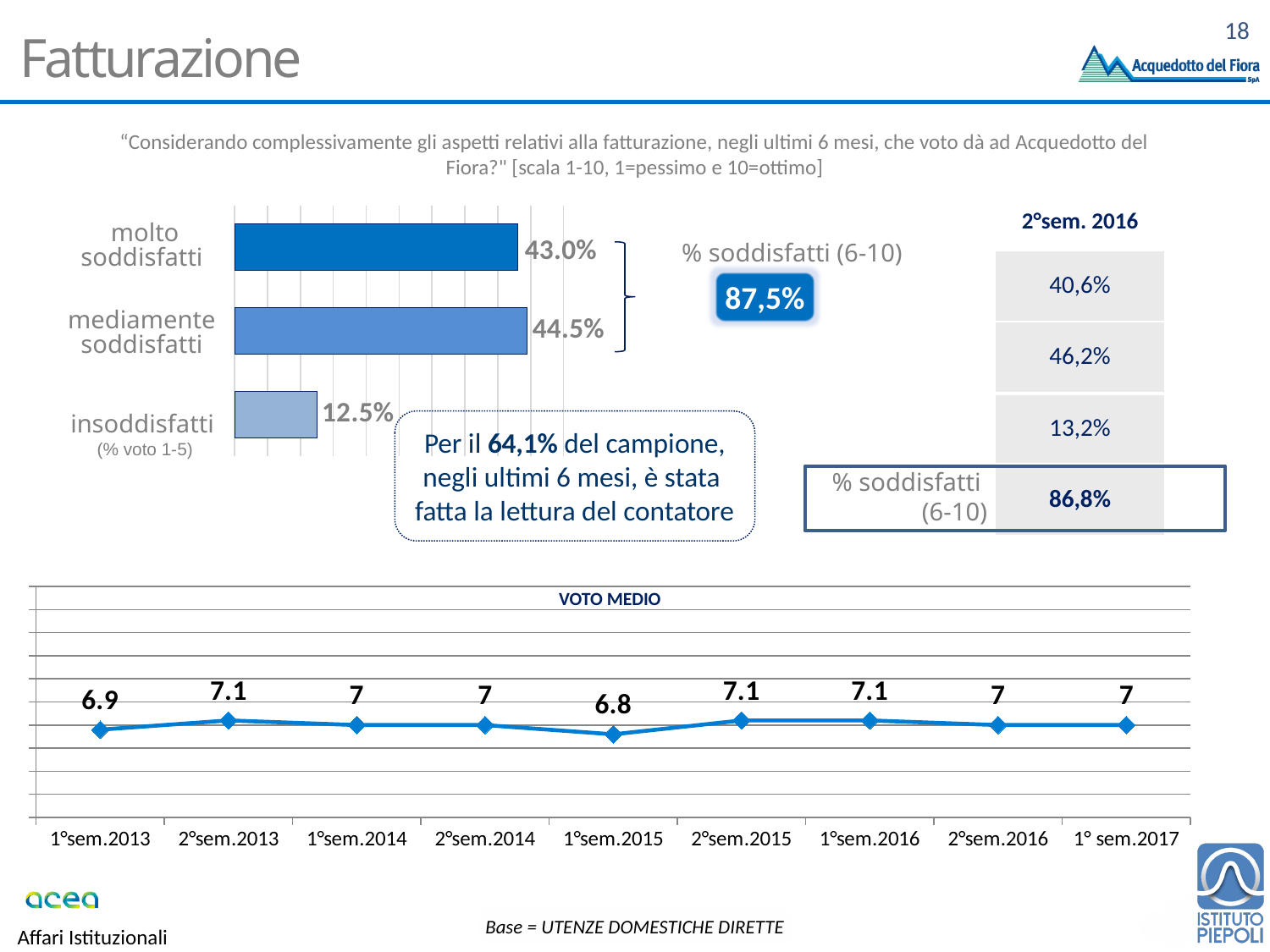
In the "VOTO MEDIO" chart, which period has the lowest value? 1°sem.2015 What kind of chart is the chart at the top of the slide? bar chart In the bar chart at the top of the slide, what is the value for "molto soddisfatti"? 43.0% In the "VOTO MEDIO" chart, what is the value for 1°sem.2015? 6.8 In the bar chart at the top of the slide, what is the difference between "mediamente soddisfatti" and "molto soddisfatti"? 1.5% In the "VOTO MEDIO" chart, is the value for 2°sem.2013 larger or smaller than the value for 1°sem.2013? larger In the bar chart at the top of the slide, what is the value for "insoddisfatti"? 12.5% In the bar chart at the top of the slide, which category has the highest value? mediamente soddisfatti In the "VOTO MEDIO" chart, how many periods are plotted? 9 In the "VOTO MEDIO" chart, what is the value for 1° sem.2017? 7 In the bar chart at the top of the slide, how many categories are shown? 3 In the bar chart at the top of the slide, which category has the lowest value? insoddisfatti